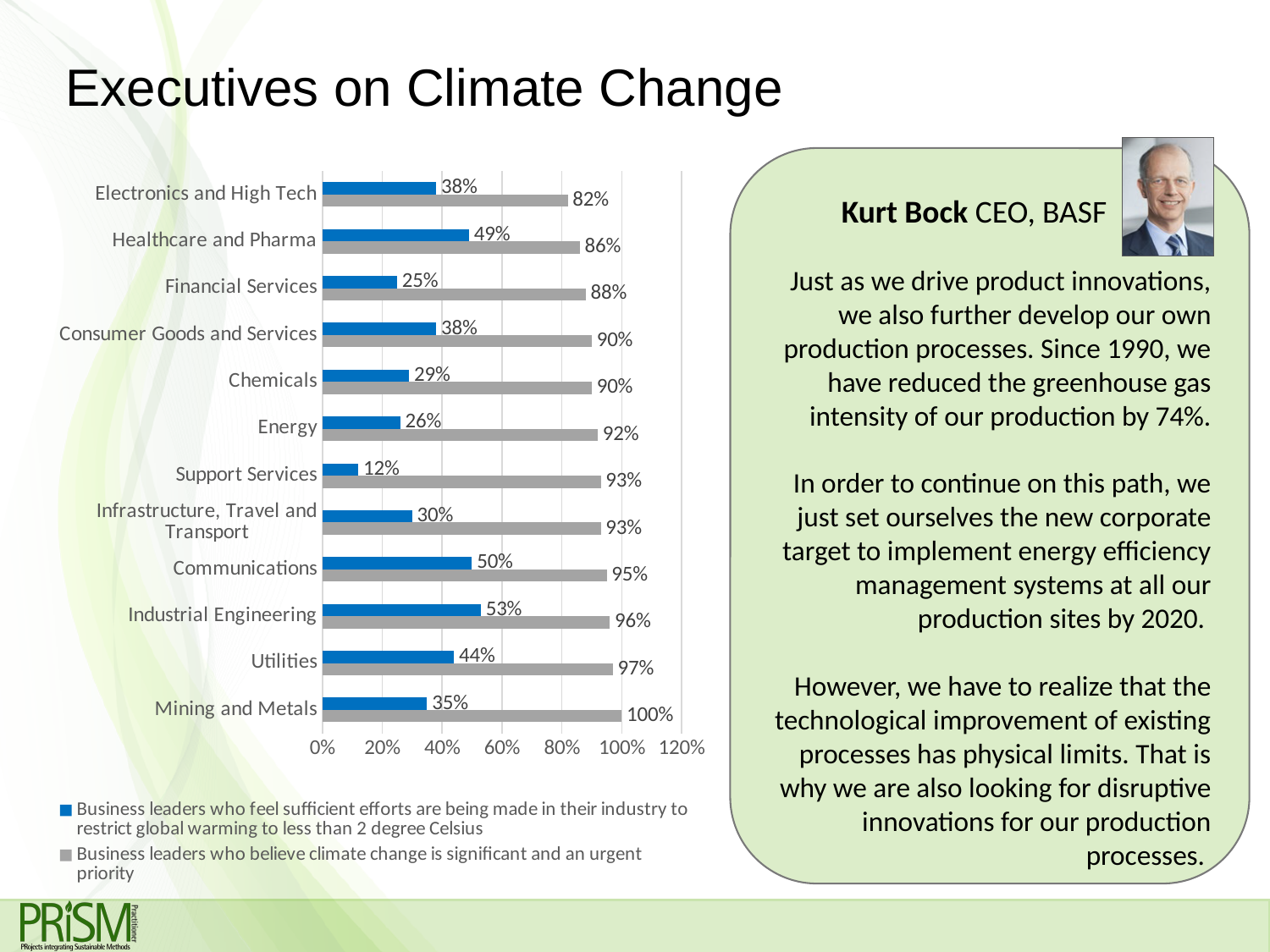
How many series does the legend list? 2 Which industry has the highest percentage of business leaders who believe climate change is significant and an urgent priority? Mining and Metals Which industry has the highest percentage of business leaders who feel sufficient efforts are being made in their industry? Industrial Engineering What kind of chart is shown on the slide? Bar chart What percentage of business leaders in Financial Services feel sufficient efforts are being made in their industry to restrict global warming to less than 2 degree Celsius? 25% Which industry has the lowest percentage of business leaders who feel sufficient efforts are being made in their industry? Support Services What is the difference between the percentage of Electronics and High Tech leaders who believe climate change is an urgent priority and the percentage of Mining and Metals leaders who believe the same? 18% What percentage of business leaders in Energy believe climate change is significant and an urgent priority? 92% What is the difference between the two percentages shown for Utilities? 53% Which colour represents business leaders who believe climate change is significant and an urgent priority? Grey Which is larger: the percentage of Communications leaders who feel sufficient efforts are being made, or the percentage of Healthcare and Pharma leaders who feel sufficient efforts are being made? Communications How many industries are shown in the chart? 12